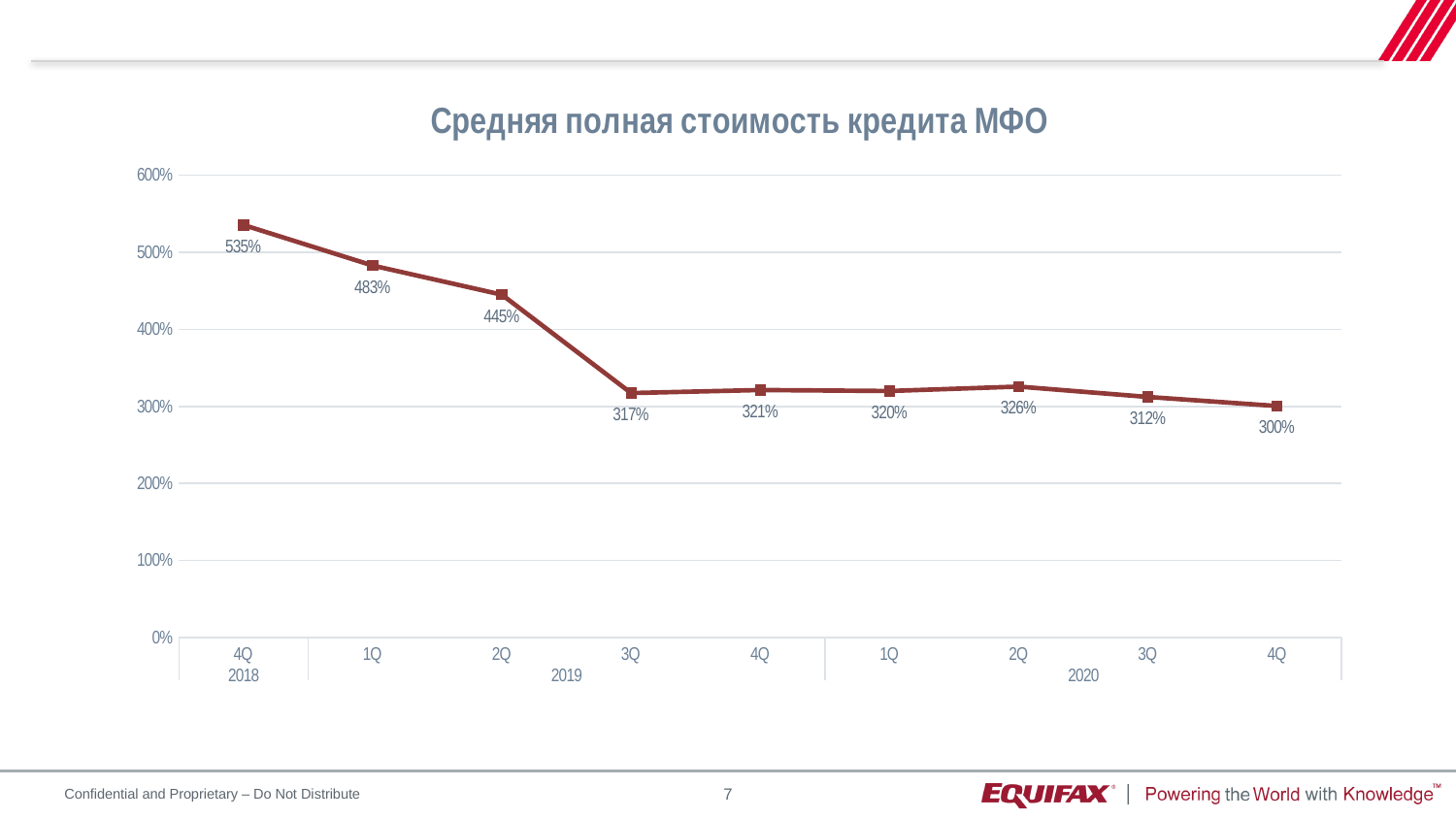
What is the difference between the values for 4Q 2018 and 1Q 2019? 52% Is the value for 2Q 2019 greater or less than 400%? greater What is the title of the chart? Средняя полная стоимость кредита МФО What kind of chart is shown on the slide? line chart Which is larger, the value for 2Q 2020 or the value for 3Q 2020? 2Q 2020 What is the value for 4Q 2020? 300% What is the difference between the values for 2Q 2019 and 3Q 2019? 128% What is the value for 2Q 2020? 326% Which quarter has the lowest value? 4Q 2020 What is the value for 4Q 2018? 535% Which quarter has the highest value? 4Q 2018 How many data points are plotted on the chart? 9